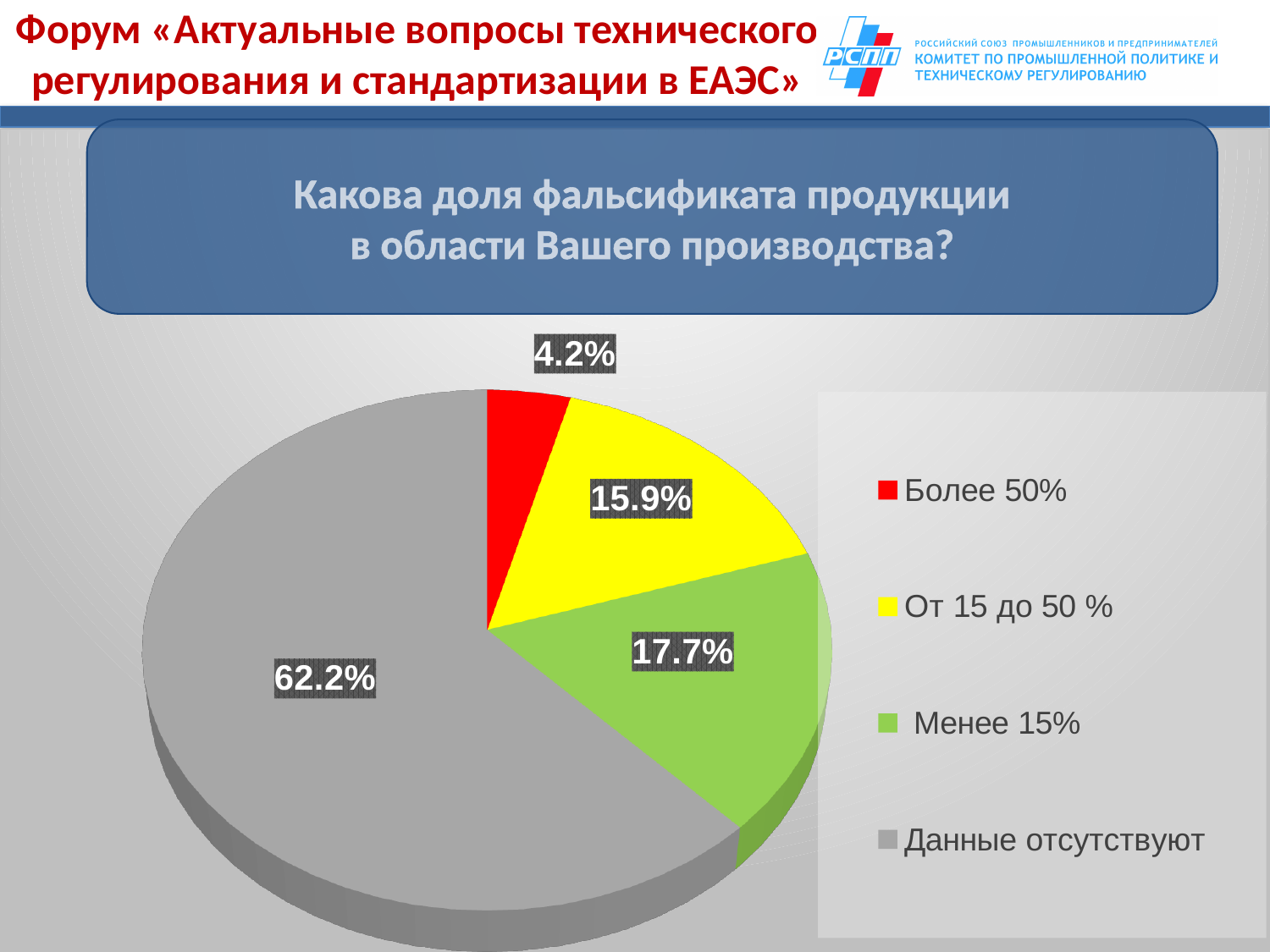
What is the value shown for "Более 50%"? 4.2% What kind of chart is shown on the slide? pie chart What is the value shown for "Менее 15%"? 17.7% Which category has the smallest slice of the pie? Более 50% What is the value shown for "От 15 до 50 %"? 15.9% How many slices does the pie chart have? 4 What is the difference between the "Данные отсутствуют" slice and the "Менее 15%" slice? 44.5% What colour is the slice for "От 15 до 50 %"? yellow Which is larger, the slice for "Менее 15%" or the slice for "От 15 до 50 %"? Менее 15% What question is the chart answering, according to the title above it? Какова доля фальсификата продукции в области Вашего производства? Which category has the largest slice of the pie? Данные отсутствуют What share of the pie is labelled "Данные отсутствуют"? 62.2%